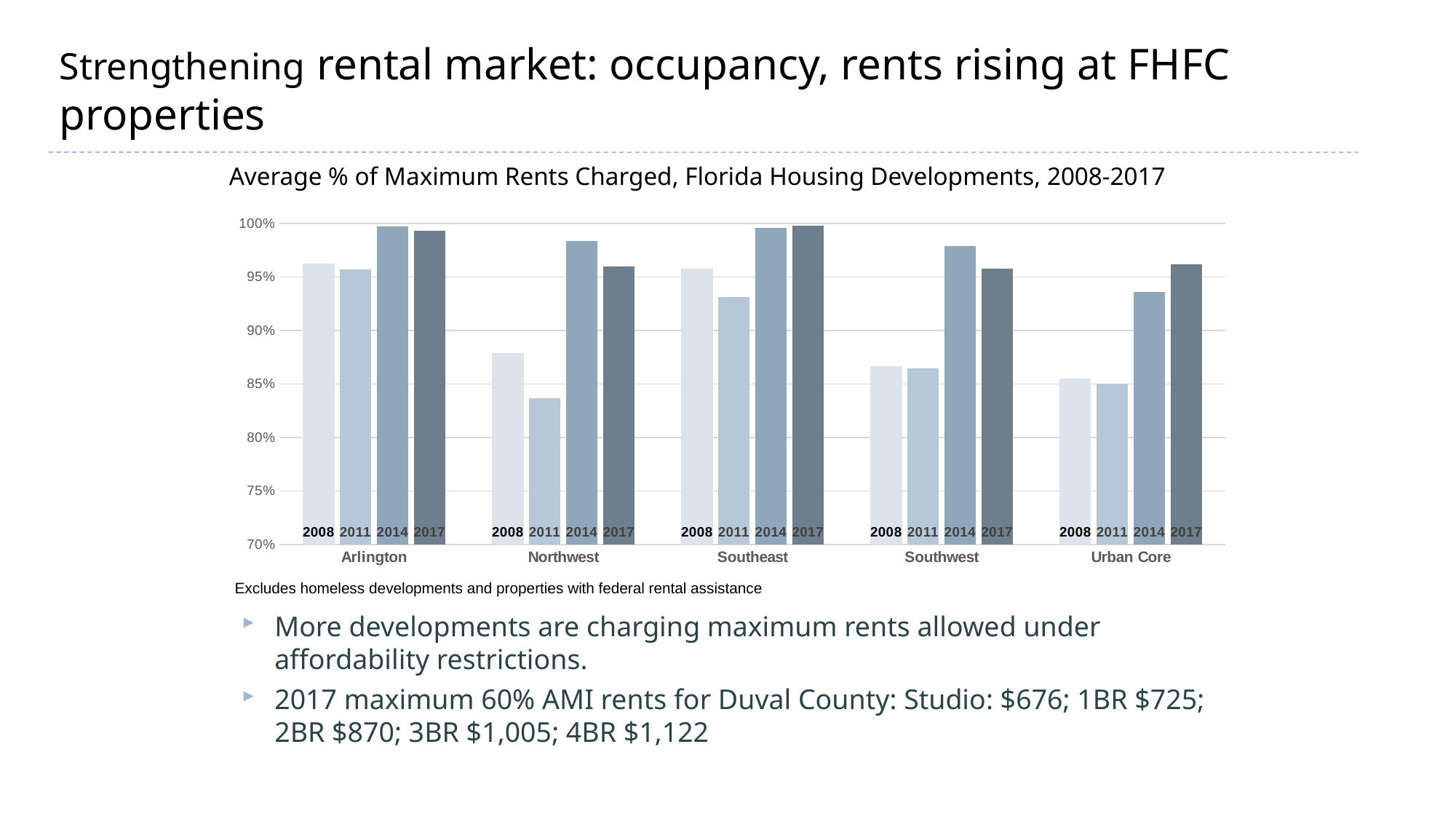
Is the value for Northwest in 2011 greater or less than 85%? less Is the value for Urban Core in 2014 greater or less than 90%? greater How many neighborhood categories are shown on the x axis of the chart? 5 For Southwest, which is larger: the 2014 value or the 2017 value? 2014 Is the value for Arlington in 2014 greater or less than 95%? greater Which year has the lowest value for Northwest? 2011 For Urban Core, do the values rise or fall from 2011 to 2017? rise Which year has the highest value for Urban Core? 2017 What kind of chart is shown on the slide? Bar chart What is the title of the chart? Average % of Maximum Rents Charged, Florida Housing Developments, 2008-2017 How many years are plotted for each neighborhood in the chart? 4